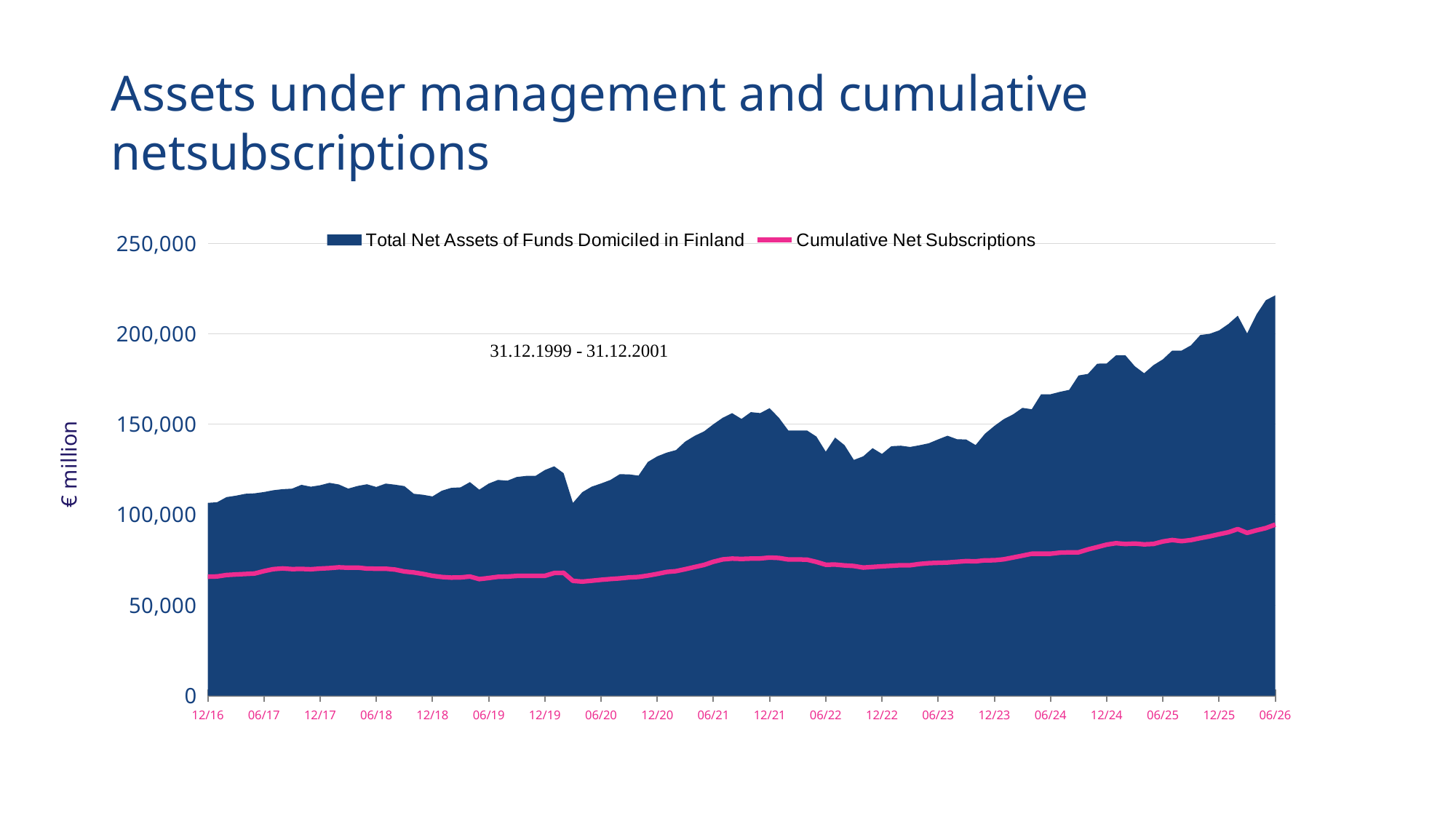
What is the label on the y axis? € million At which x-axis date does Total Net Assets of Funds Domiciled in Finland reach its highest value? 06/26 How many date labels are shown on the x axis? 20 How many series does the legend list? 2 Is the value for Cumulative Net Subscriptions at 06/26 greater or less than 100,000? less Is the value for Cumulative Net Subscriptions at 12/16 greater or less than 50,000? greater Does Total Net Assets of Funds Domiciled in Finland rise or fall overall from 12/16 to 06/26? rise Is the value for Total Net Assets of Funds Domiciled in Finland at 06/22 greater or less than 150,000? less At 06/26, which is larger: Total Net Assets of Funds Domiciled in Finland or Cumulative Net Subscriptions? Total Net Assets of Funds Domiciled in Finland What colour is the Cumulative Net Subscriptions line? Pink What kind of chart is shown on the slide? Area chart with a line series